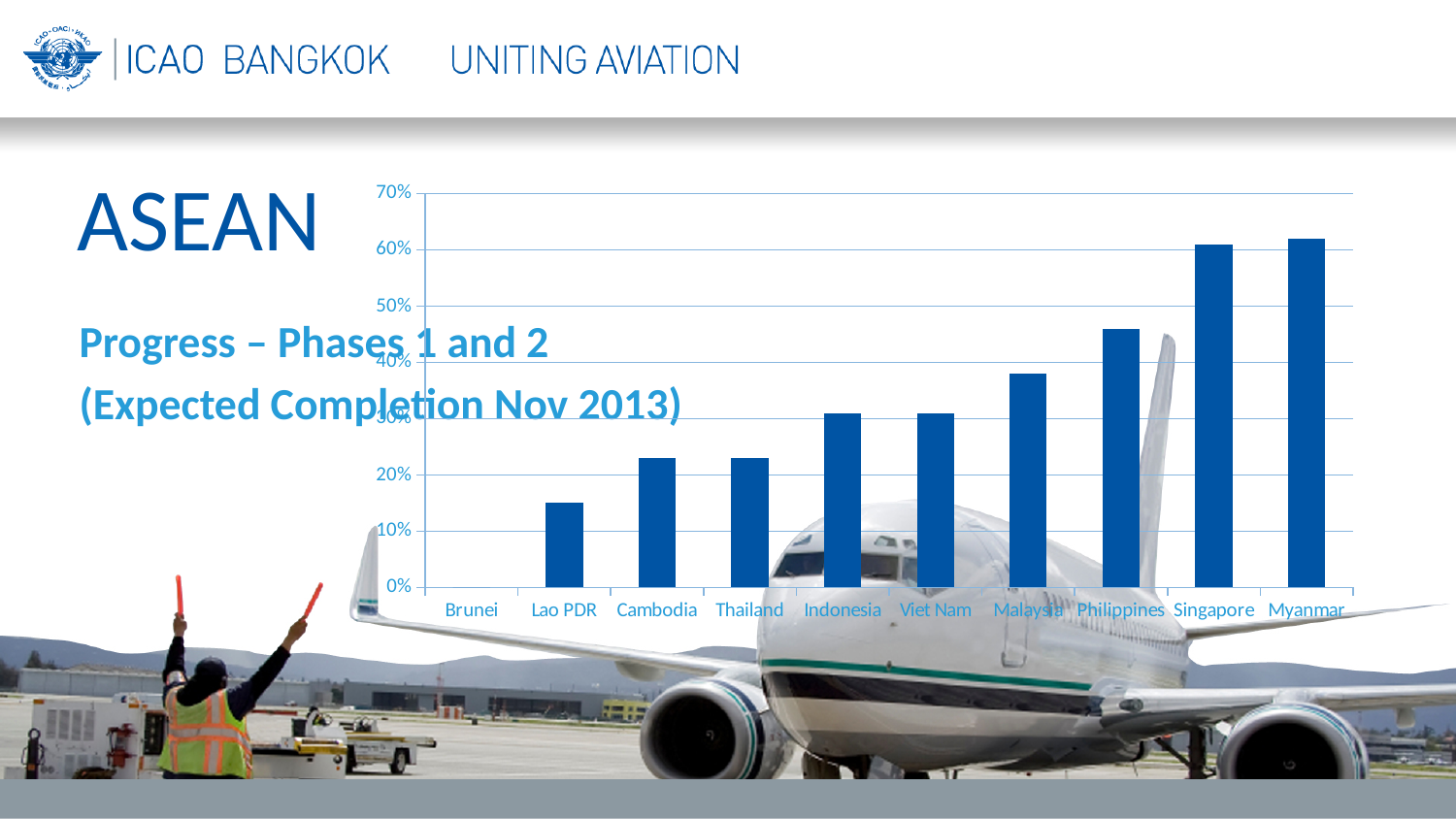
Is the value for Philippines greater or less than 40%? greater What is the highest value shown on the chart's vertical axis? 70% How many countries are shown on the x axis of the chart? 10 Which has the larger value, Philippines or Malaysia? Philippines Is the value for Singapore greater or less than 50%? greater Which has the larger value, Lao PDR or Cambodia? Cambodia Which country has the lowest value in the chart? Brunei Is the value for Cambodia greater or less than 30%? less Do the values generally rise or fall from left to right along the x axis? rise What kind of chart is shown on the slide? bar chart